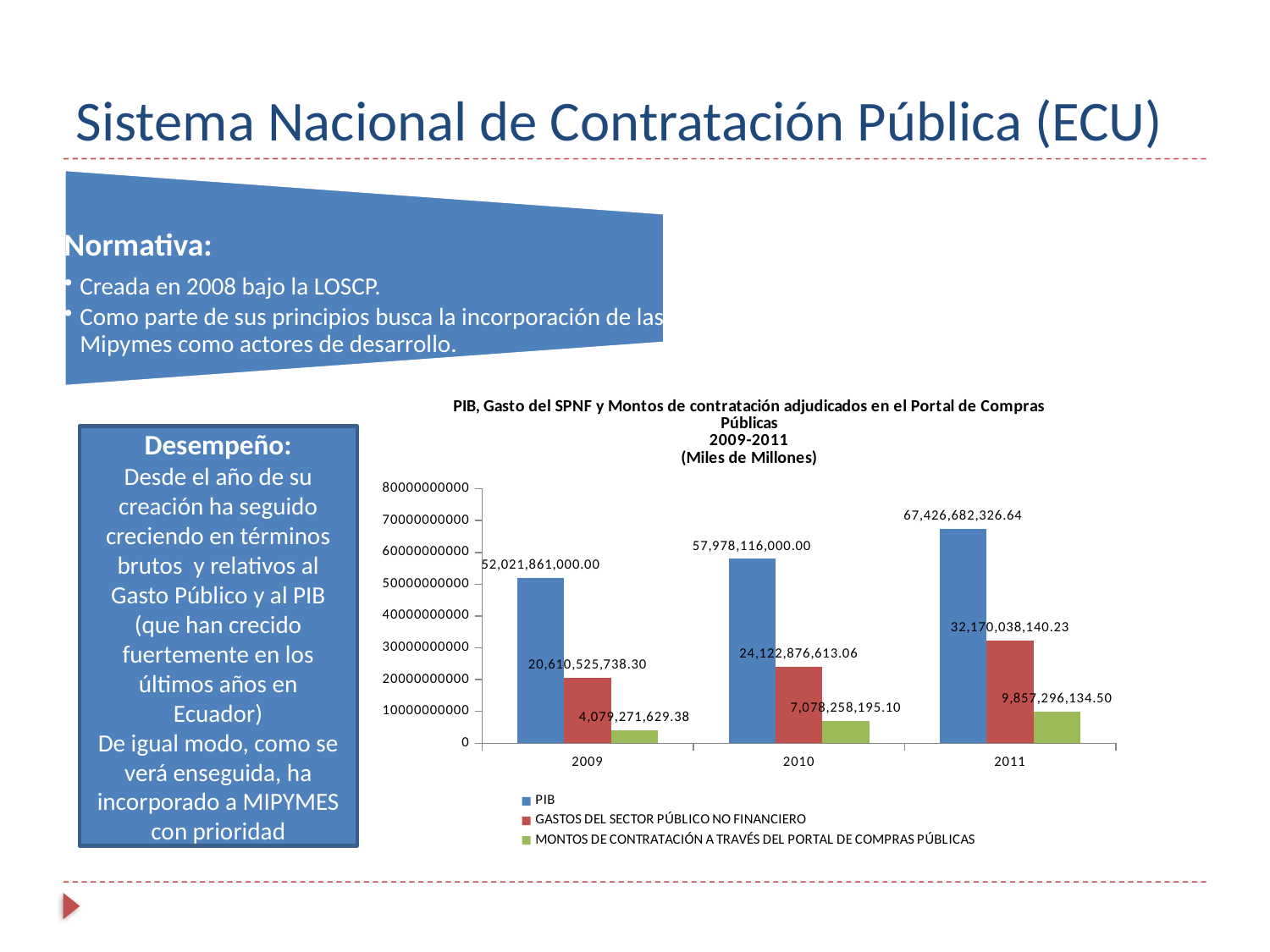
How many years are shown on the x axis of the chart? 3 What is the value of GASTOS DEL SECTOR PÚBLICO NO FINANCIERO for 2010? 24,122,876,613.06 What is the value of MONTOS DE CONTRATACIÓN A TRAVÉS DEL PORTAL DE COMPRAS PÚBLICAS for 2009? 4,079,271,629.38 Do the GASTOS DEL SECTOR PÚBLICO NO FINANCIERO values rise or fall from 2009 to 2011? Rise Is the PIB value for 2010 greater or less than 60000000000? less How many series does the chart legend list? 3 In which year is the PIB value highest? 2011 What is the PIB value for 2011? 67,426,682,326.64 In which year is the MONTOS DE CONTRATACIÓN A TRAVÉS DEL PORTAL DE COMPRAS PÚBLICAS value lowest? 2009 What type of chart is shown on the slide? Bar chart Which is larger: GASTOS DEL SECTOR PÚBLICO NO FINANCIERO in 2011 or PIB in 2009? PIB in 2009 What is the difference between the PIB values for 2011 and 2010? 9,448,566,326.64